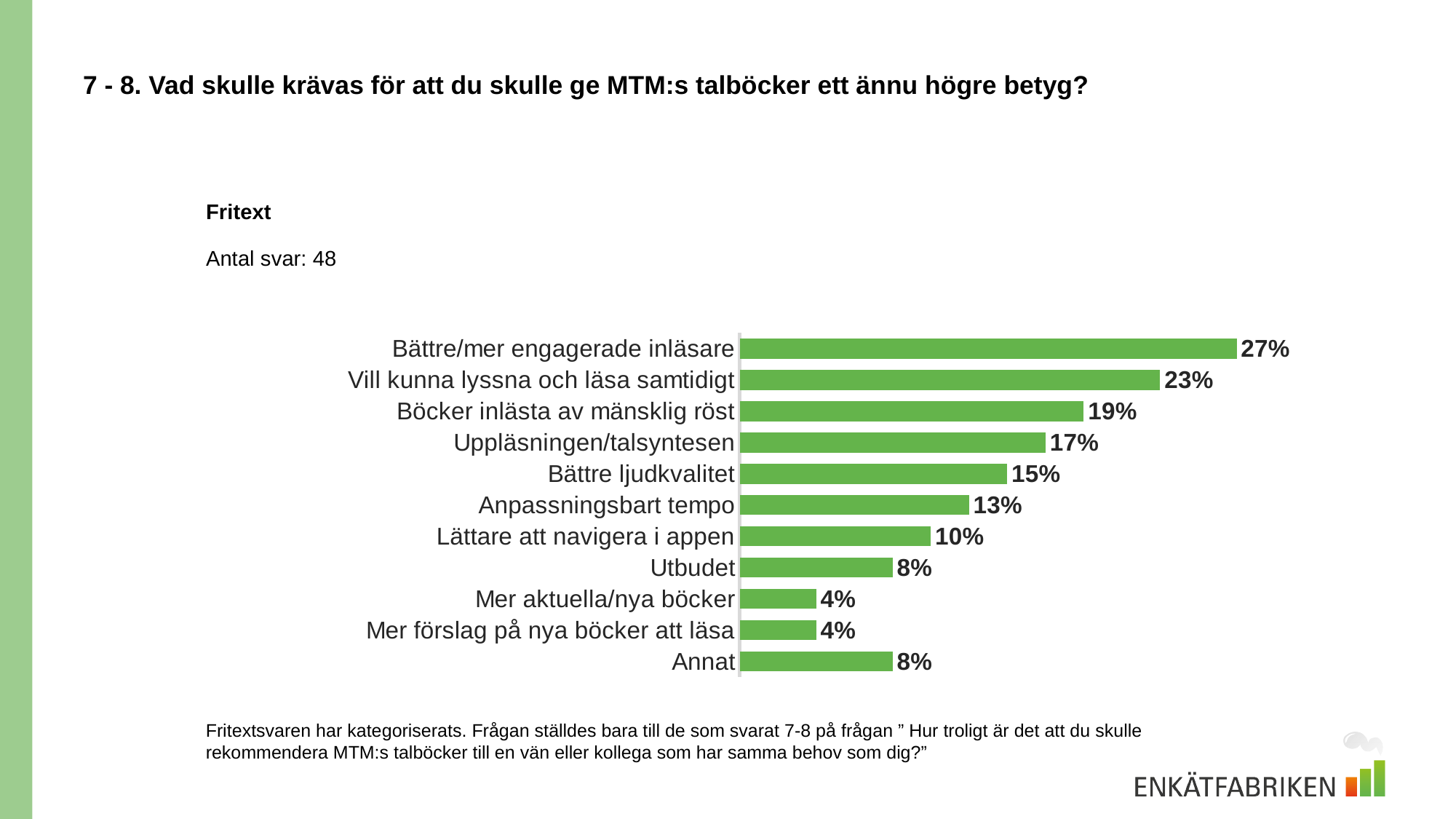
What is the value for "Lättare att navigera i appen"? 10% Which is larger, "Anpassningsbart tempo" or "Annat"? Anpassningsbart tempo What colour are the bars in the chart? Green What kind of chart is shown on the slide? Bar chart What is the difference between "Vill kunna lyssna och läsa samtidigt" and "Böcker inlästa av mänsklig röst"? 4% What is the difference between "Bättre ljudkvalitet" and "Utbudet"? 7% What is the value for "Mer aktuella/nya böcker"? 4% How many responses (Antal svar) does the slide report? 48 What is the value for "Bättre/mer engagerade inläsare"? 27% How many categories are shown in the chart? 11 What is the value for "Uppläsningen/talsyntesen"? 17% Which category has the highest value? Bättre/mer engagerade inläsare